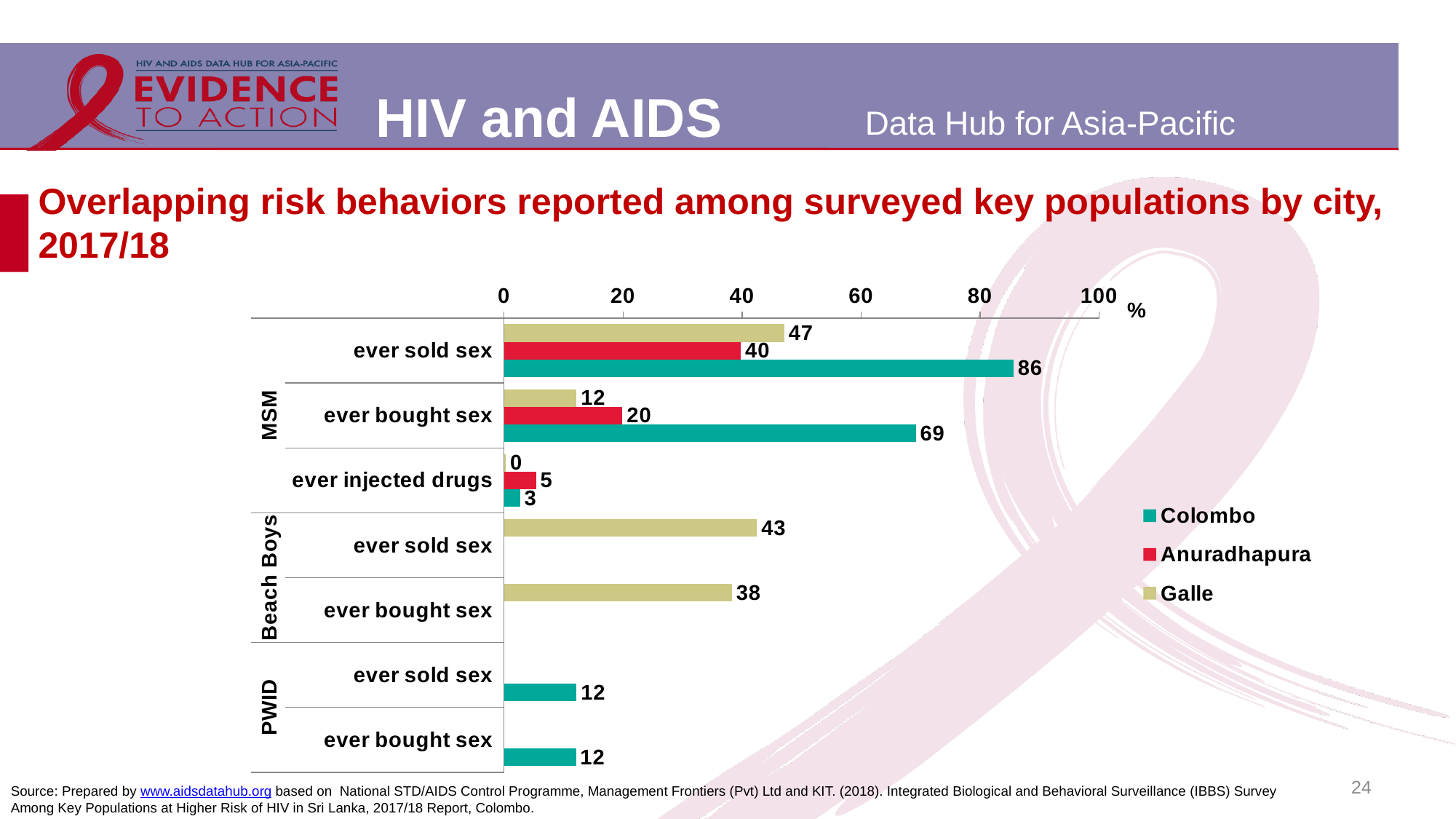
What percentage of PWID in Colombo reported having ever bought sex? 12 What is the difference between the Colombo and Anuradhapura values for MSM who ever bought sex? 49 Which city has the highest value for MSM who ever sold sex? Colombo How many series does the legend list? 3 What percentage of MSM in Galle reported having ever bought sex? 12 What percentage of MSM in Colombo reported having ever sold sex? 86 What percentage of Beach Boys in Galle reported having ever sold sex? 43 For MSM who ever sold sex, which is larger: the Galle value or the Anuradhapura value? Galle What percentage of MSM in Anuradhapura reported having ever injected drugs? 5 What type of chart is shown on the slide? Bar chart Which city has the lowest value for MSM who ever injected drugs? Galle Which colour represents Anuradhapura in the chart? Red